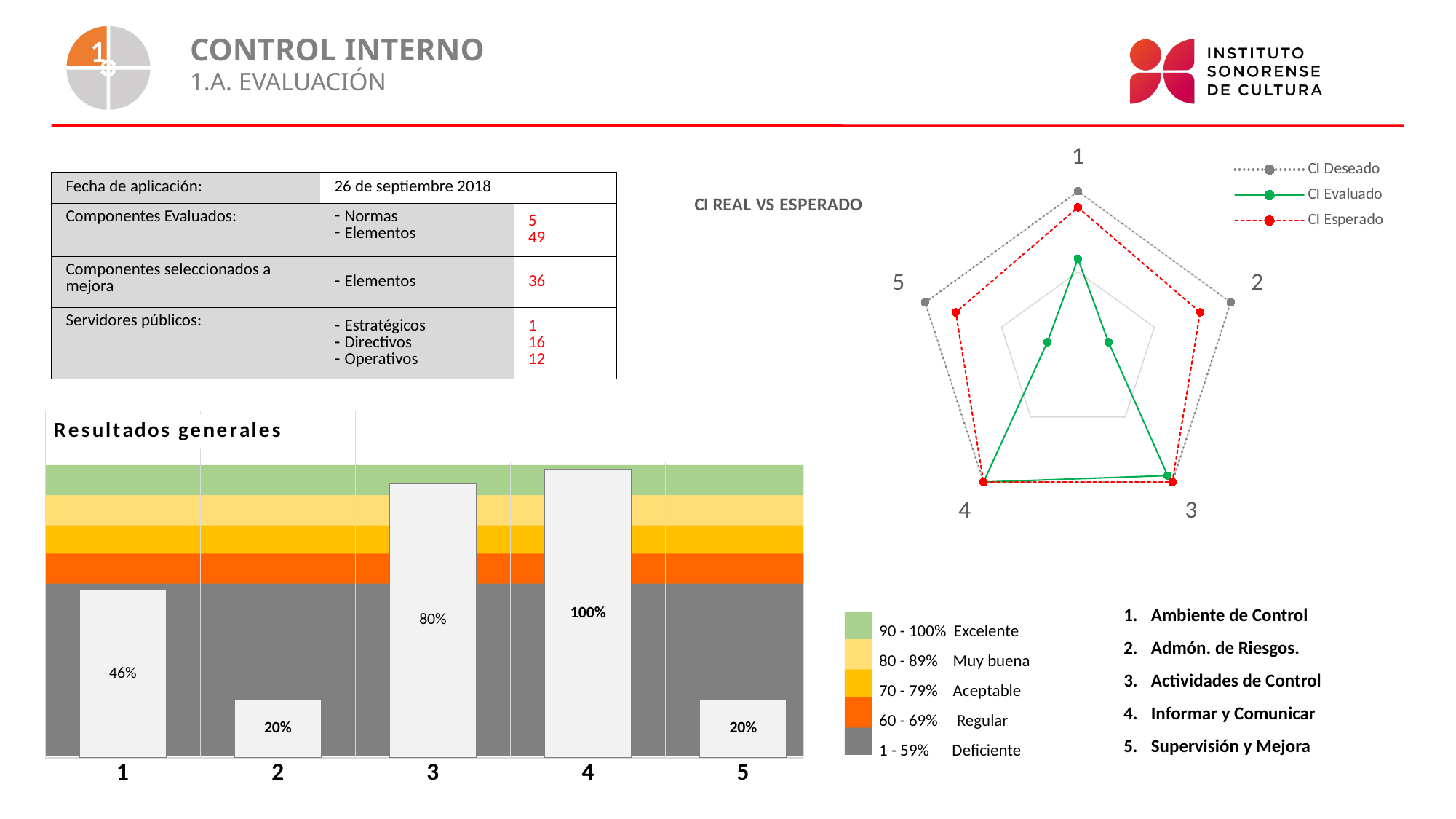
In the 'Resultados generales' chart, what is the difference between the values for category 3 and category 2? 60% In the 'Resultados generales' chart, which rating band does the green colour at the top represent according to the legend? 90 - 100% Excelente In the 'Resultados generales' chart, which category has the highest value? 4 In the 'Resultados generales' chart, which is larger, the value for category 3 or the value for category 5? Category 3 In the 'Resultados generales' chart, what is the difference between the values for category 4 and category 1? 54% In the 'Resultados generales' chart, what is the value for category 3? 80% In the 'Resultados generales' chart, what is the value for category 1? 46% What kind of chart is 'Resultados generales'? Bar chart What kind of chart is 'CI REAL VS ESPERADO'? Radar chart In the 'Resultados generales' chart, how many categories are shown on the x axis? 5 In the 'CI REAL VS ESPERADO' chart, which series is drawn with a green solid line? CI Evaluado In the 'CI REAL VS ESPERADO' chart, how many series does the legend list? 3